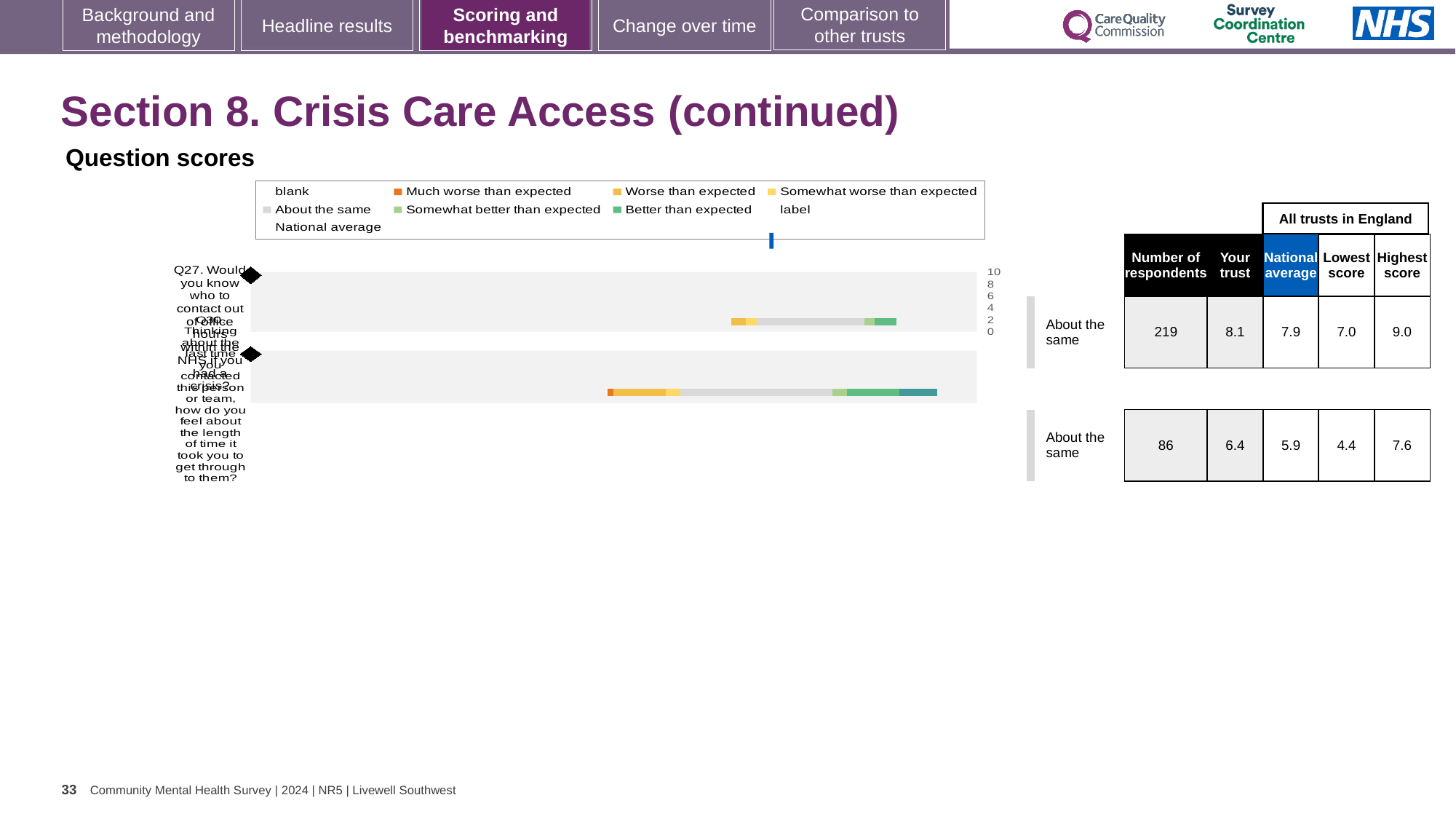
What is the number of respondents for Q27? 219 Which question has the higher 'Your trust' score, Q27 or Q30? Q27 Which legend entry is shown with an orange marker? Much worse than expected What is the difference between the 'Your trust' score and the national average for Q30? 0.5 What is the national average score for Q27? 7.9 What is the difference between the highest and lowest scores for Q27? 2.0 What kind of chart is shown under 'Question scores'? bar chart What is the highest score among all trusts in England for Q30? 7.6 How many questions (categories) are plotted in the chart? 2 Which question has the lower number of respondents? Q30 What is the 'Your trust' score for Q30? 6.4 What is the benchmark category shown next to the bar for Q27? About the same